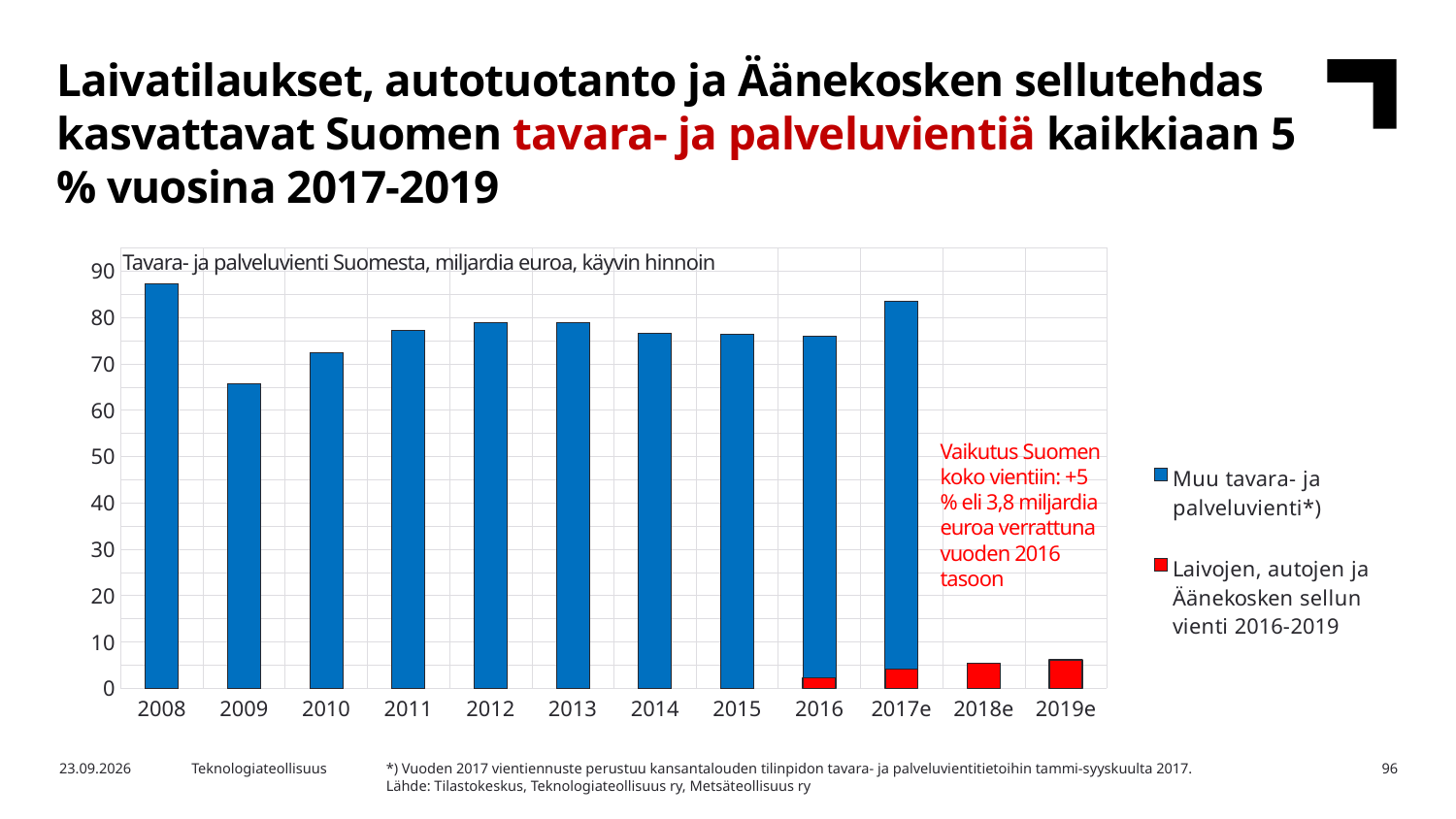
How many series does the legend list? 2 Is the total value for 2017e greater or less than 80? greater How many years are shown on the x axis? 12 Which is larger, the bar for 2008 or the bar for 2009? 2008 What kind of chart is shown on the slide? bar chart Is the value for 2008 greater or less than 80? greater Do the values rise or fall from 2008 to 2009? fall Is the value for 2009 greater or less than 70? less What is the title of the chart? Tavara- ja palveluvienti Suomesta, miljardia euroa, käyvin hinnoin Which year has the highest bar for Muu tavara- ja palveluvienti*)? 2008 Among the years 2008 to 2017e, which year has the lowest bar for Muu tavara- ja palveluvienti*)? 2009